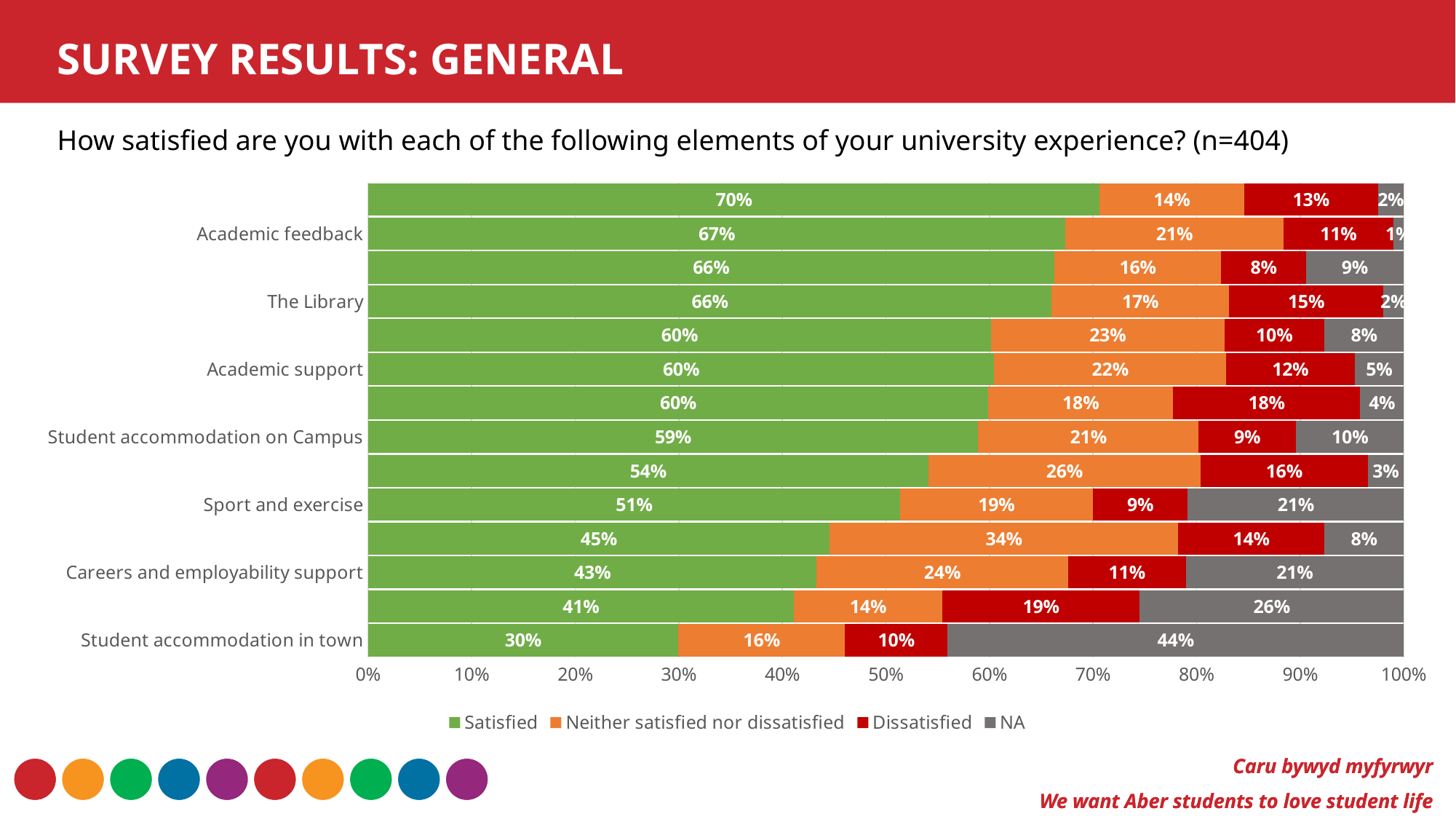
What is the 'Neither satisfied nor dissatisfied' value for Careers and employability support? 24% Which has a larger Dissatisfied share, The Library or Sport and exercise? The Library What percentage of respondents answered NA for Student accommodation in town? 44% How many bars (categories) are plotted in the chart? 14 How many series does the legend list? 4 Which category has the lowest Satisfied share? Student accommodation in town What is the Dissatisfied value for The Library? 15% What is the Satisfied value for Academic feedback? 67% What kind of chart is shown on the slide? Stacked bar chart Which category has the highest NA share? Student accommodation in town What is the difference in Satisfied share between Academic feedback and Student accommodation in town? 37 percentage points What is the total of the four segments in the Student accommodation in town bar? 100%